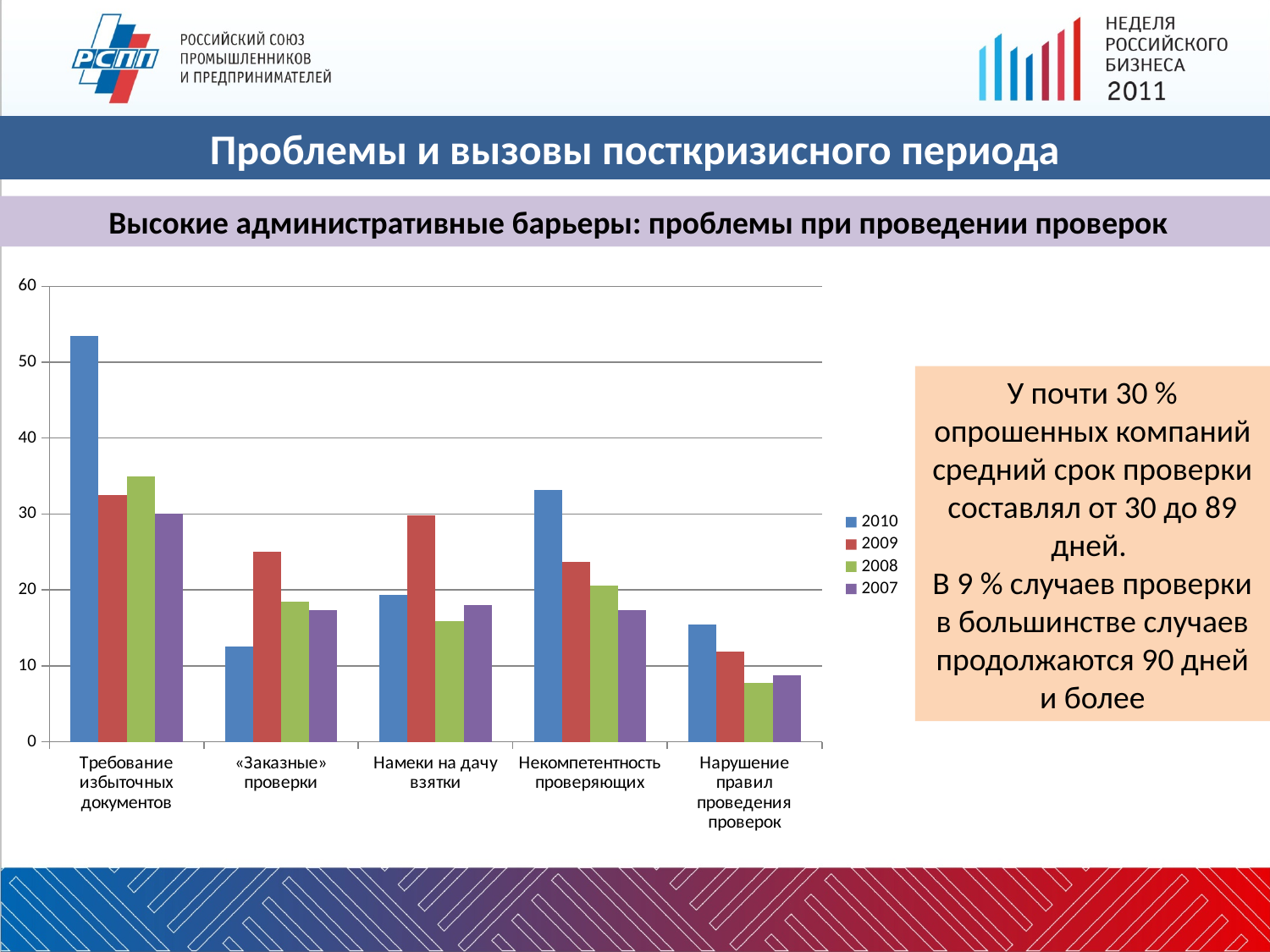
Which category has the highest value for the 2010 series? Требование избыточных документов For Некомпетентность проверяющих, which series has the larger value: 2010 or 2007? 2010 Is the 2009 value for Намеки на дачу взятки greater or less than 25? greater How many categories are shown on the x axis of the chart? 5 Which category has the lowest value for the 2008 series? Нарушение правил проведения проверок For Намеки на дачу взятки, which year has the highest value? 2009 For «Заказные» проверки, which series has the larger value: 2010 or 2009? 2009 What kind of chart is shown on the slide? bar chart Which series are listed in the chart's legend? 2010, 2009, 2008, 2007 How many series does the chart's legend list? 4 Is the 2010 value for Требование избыточных документов greater or less than 50? greater Is the 2008 value for Нарушение правил проведения проверок greater or less than 10? less